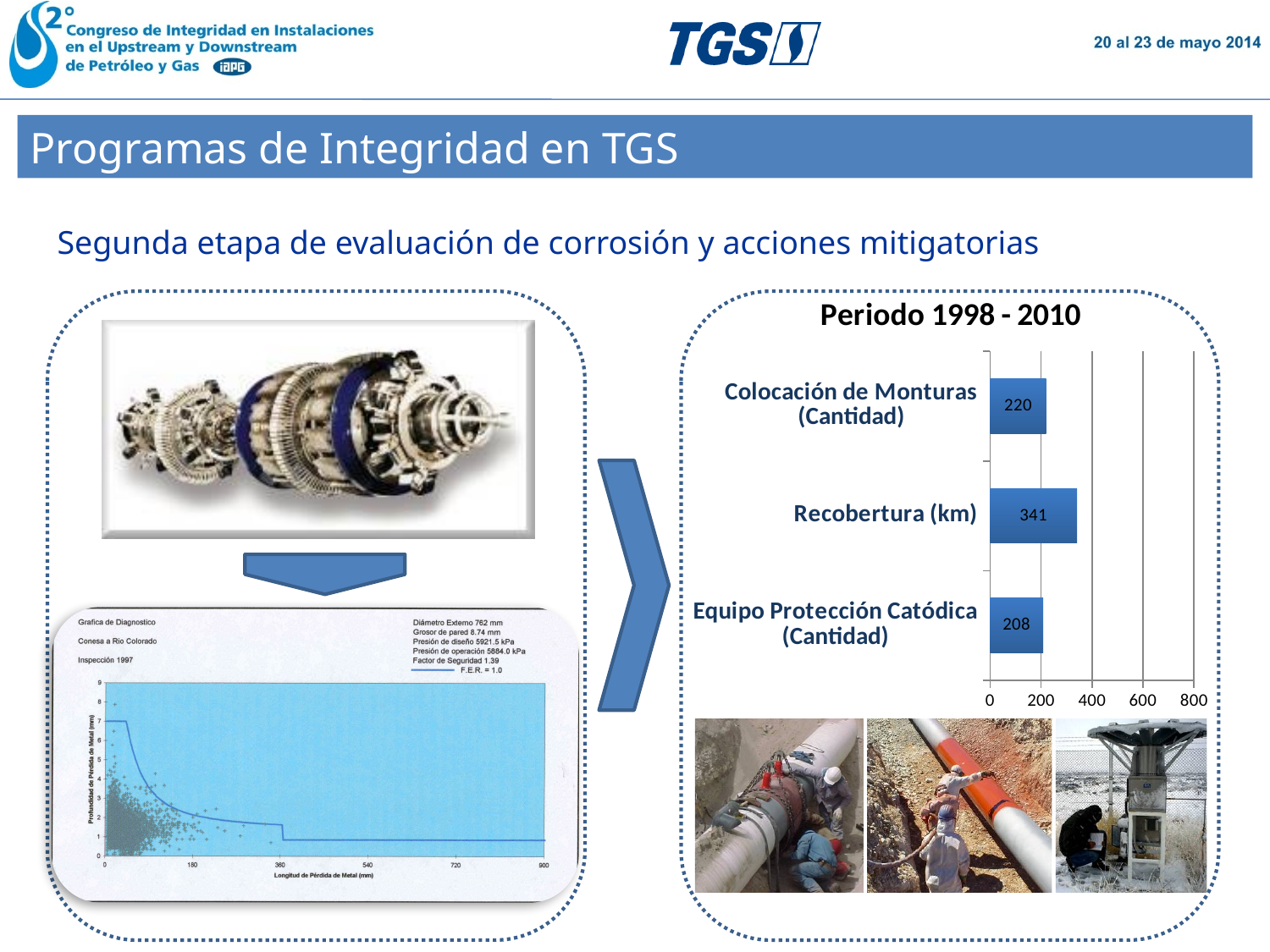
In the 'Periodo 1998 - 2010' chart, what is the difference between Colocación de Monturas (Cantidad) and Equipo Protección Catódica (Cantidad)? 12 In the 'Periodo 1998 - 2010' chart, what is the value for Colocación de Monturas (Cantidad)? 220 In the 'Periodo 1998 - 2010' chart, which is larger: Recobertura (km) or Equipo Protección Catódica (Cantidad)? Recobertura (km) In the 'Periodo 1998 - 2010' chart, which category has the highest value? Recobertura (km) In the 'Periodo 1998 - 2010' chart, what is the value for Recobertura (km)? 341 In the 'Periodo 1998 - 2010' chart, is the value for Recobertura (km) greater or less than 400? less In the 'Periodo 1998 - 2010' chart, what is the highest value shown on the horizontal axis? 800 What kind of chart is the 'Periodo 1998 - 2010' chart? Bar chart In the 'Periodo 1998 - 2010' chart, which category has the lowest value? Equipo Protección Catódica (Cantidad) How many categories are shown in the 'Periodo 1998 - 2010' chart? 3 In the 'Periodo 1998 - 2010' chart, what is the difference between Recobertura (km) and Colocación de Monturas (Cantidad)? 121 In the 'Periodo 1998 - 2010' chart, what is the value for Equipo Protección Catódica (Cantidad)? 208